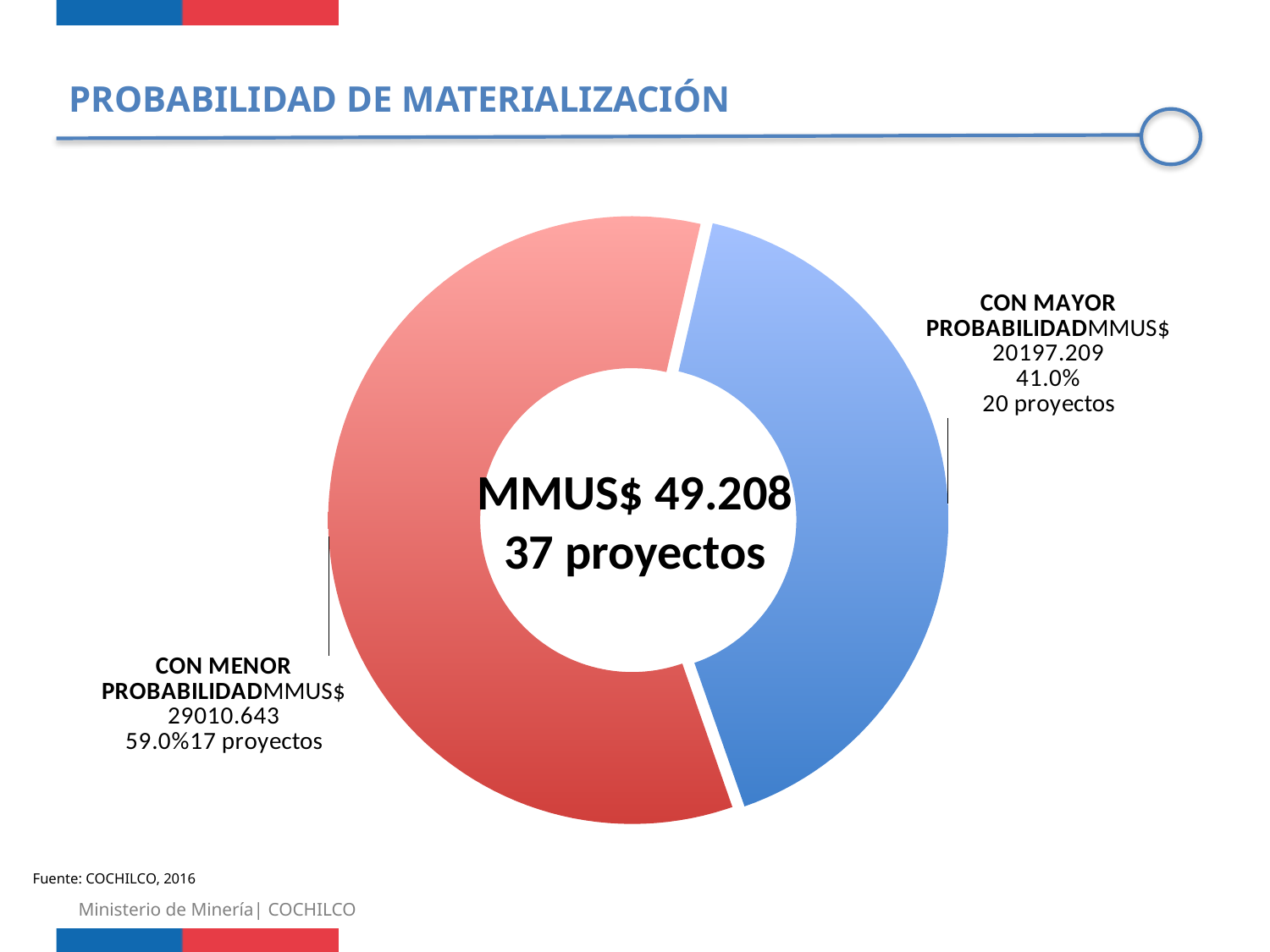
What is the difference in percentage points between the CON MENOR PROBABILIDAD and CON MAYOR PROBABILIDAD shares? 18.0 percentage points What total value and number of projects are shown in the centre of the doughnut? MMUS$ 49.208, 37 proyectos What share of the doughnut does CON MENOR PROBABILIDAD represent? 59.0% What is the MMUS$ value for CON MAYOR PROBABILIDAD? MMUS$ 20197.209 Which category has the larger share of the doughnut? CON MENOR PROBABILIDAD What is the title of the chart on the slide? PROBABILIDAD DE MATERIALIZACIÓN What kind of chart is shown on the slide? Doughnut (pie) chart How many slices does the doughnut chart have? 2 How many projects are in the CON MAYOR PROBABILIDAD category? 20 proyectos What is the MMUS$ value for CON MENOR PROBABILIDAD? MMUS$ 29010.643 What share of the doughnut does CON MAYOR PROBABILIDAD represent? 41.0% How many projects are in the CON MENOR PROBABILIDAD category? 17 proyectos